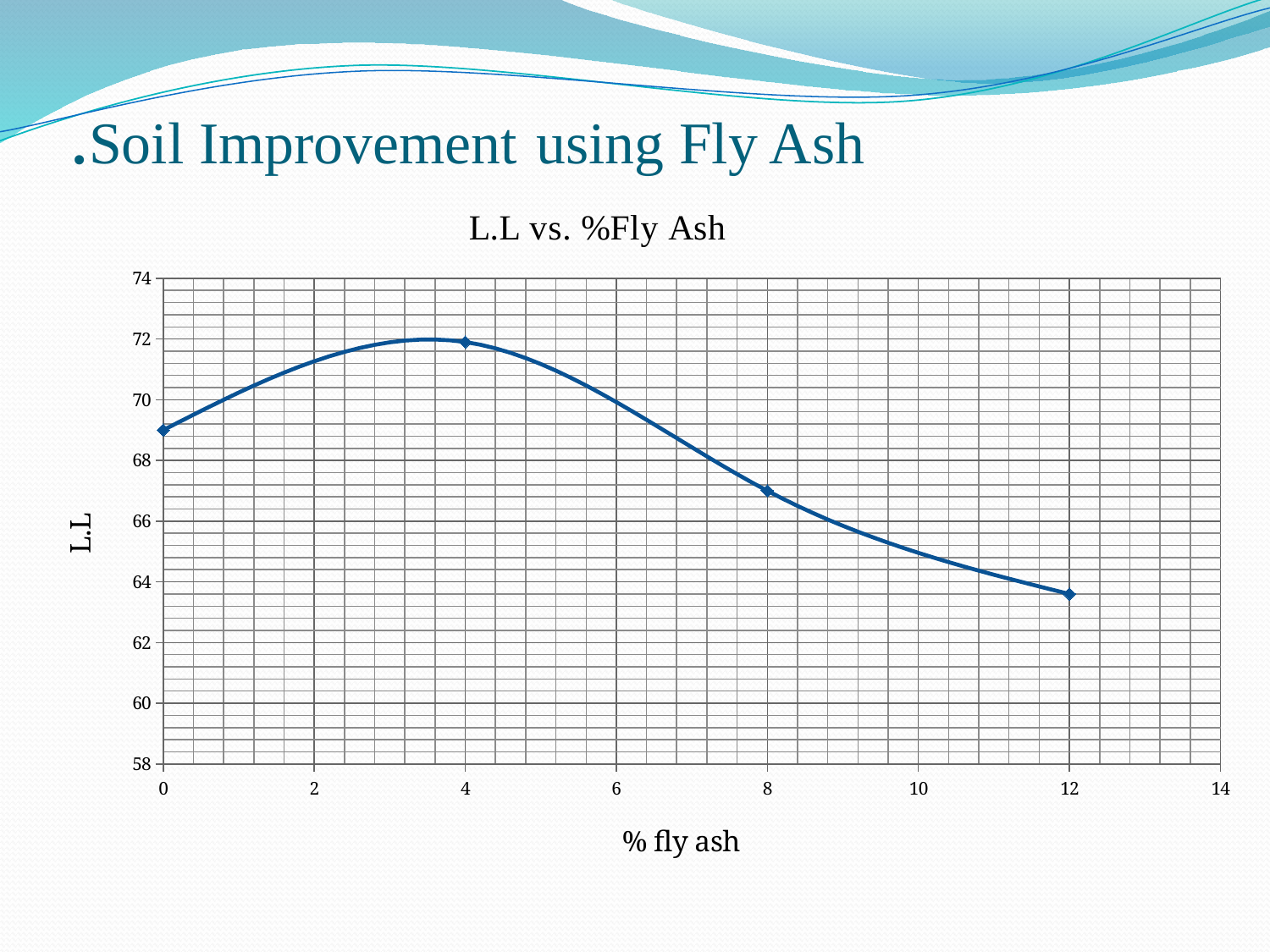
How many data points are plotted on the chart? 4 Is the L.L value at 8% fly ash greater or less than 66? greater How does L.L change as % fly ash increases from 4 to 12? It falls Which has a higher L.L value: 0% fly ash or 8% fly ash? 0% fly ash At which % fly ash value is L.L highest? 4 At which % fly ash value is L.L lowest? 12 What is the title of the chart? L.L vs. %Fly Ash Is the L.L value at 12% fly ash greater or less than 64? less What kind of chart is shown on the slide? line chart Is the L.L value at 0% fly ash greater or less than 70? less